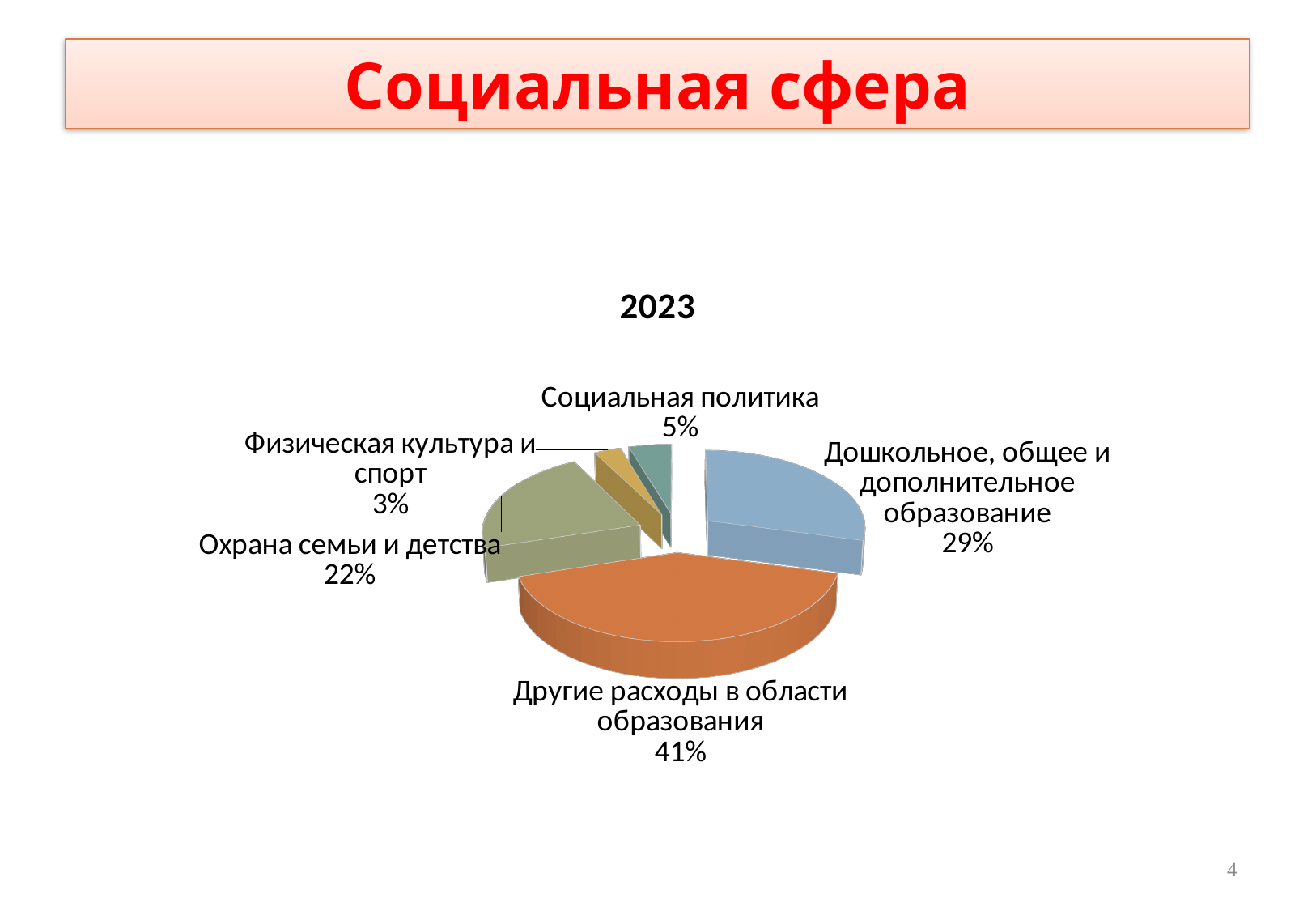
Which category has the largest slice of the pie? Другие расходы в области образования What is the difference in percentage points between "Другие расходы в области образования" and "Дошкольное, общее и дополнительное образование"? 12% Which category has the smallest slice of the pie? Физическая культура и спорт What share of the pie does "Охрана семьи и детства" have? 22% Which is larger: the share for "Охрана семьи и детства" or the share for "Социальная политика"? Охрана семьи и детства What is the title of the chart? 2023 How many slices does the pie chart have? 5 What share of the pie does "Другие расходы в области образования" have? 41% What kind of chart is shown on the slide? Pie chart What share of the pie does "Дошкольное, общее и дополнительное образование" have? 29%